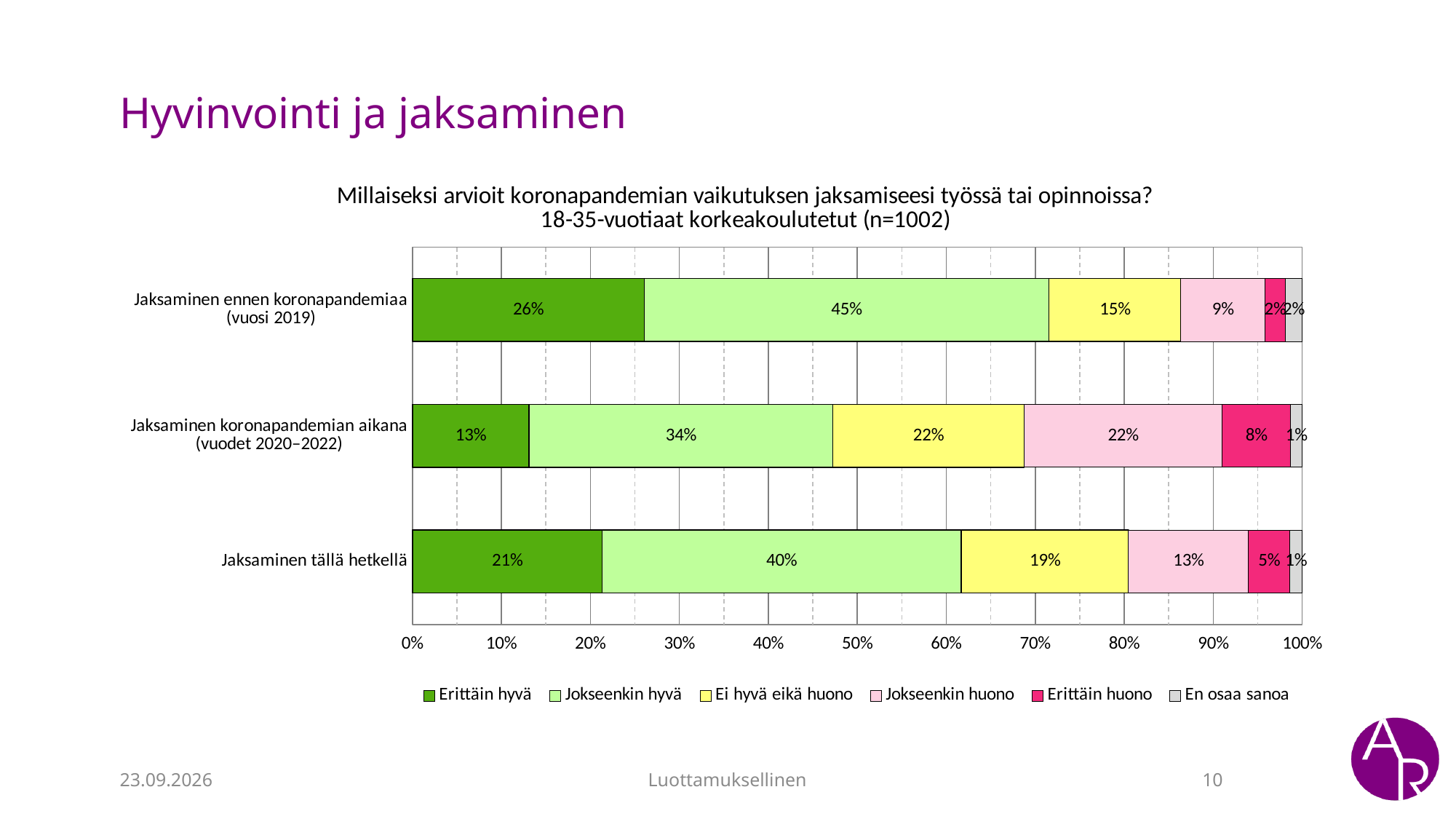
What is the difference between the "Erittäin hyvä" values for "Jaksaminen ennen koronapandemiaa (vuosi 2019)" and "Jaksaminen koronapandemian aikana (vuodet 2020–2022)"? 13% What is the value for "Jokseenkin hyvä" in the "Jaksaminen tällä hetkellä" bar? 40% Which category has the highest value for "Erittäin hyvä"? Jaksaminen ennen koronapandemiaa (vuosi 2019) How many series does the legend list? 6 How many categories (bars) are plotted in the chart? 3 What kind of chart is shown on the slide? Stacked bar chart What is the value for "Jokseenkin huono" in the "Jaksaminen koronapandemian aikana (vuodet 2020–2022)" bar? 22% Which is larger: the "Ei hyvä eikä huono" value for "Jaksaminen koronapandemian aikana (vuodet 2020–2022)" or for "Jaksaminen tällä hetkellä"? Jaksaminen koronapandemian aikana (vuodet 2020–2022) What is the title of the chart? Millaiseksi arvioit koronapandemian vaikutuksen jaksamiseesi työssä tai opinnoissa? 18-35-vuotiaat korkeakoulutetut (n=1002) What is the value for "Erittäin huono" in the "Jaksaminen koronapandemian aikana (vuodet 2020–2022)" bar? 8% What is the value for "Erittäin hyvä" in the "Jaksaminen ennen koronapandemiaa (vuosi 2019)" bar? 26% Which category has the lowest value for "Jokseenkin hyvä"? Jaksaminen koronapandemian aikana (vuodet 2020–2022)